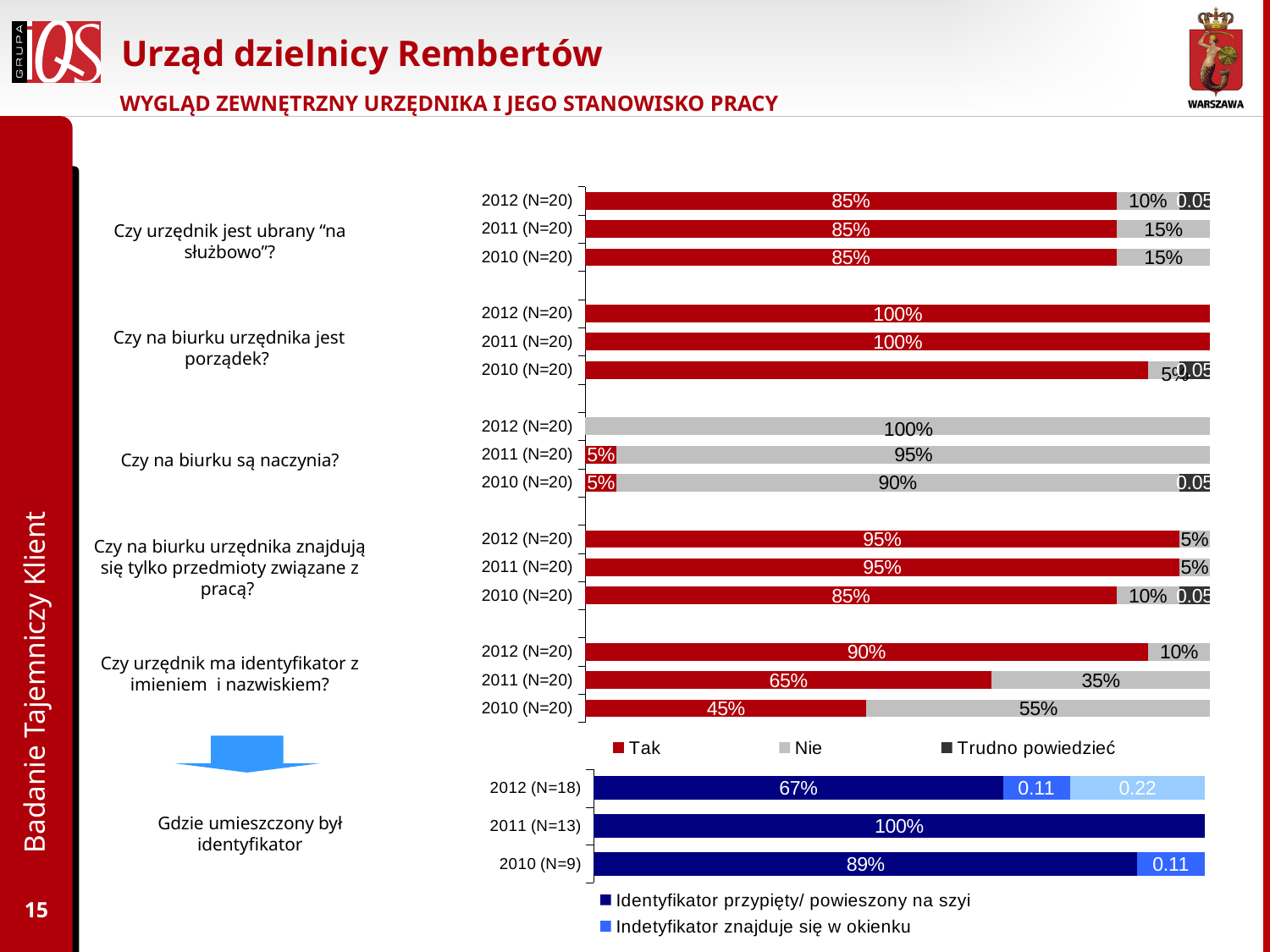
In the upper chart, what percentage answered "Nie" for "Czy urzędnik ma identyfikator z imieniem i nazwiskiem?" in 2011 (N=20)? 35% In the upper chart, what percentage answered "Tak" for "Czy urzędnik ma identyfikator z imieniem i nazwiskiem?" in 2012 (N=20)? 90% In the upper chart, what percentage answered "Nie" for "Czy urzędnik jest ubrany 'na służbowo'?" in 2012 (N=20)? 10% How many series does the legend of the upper chart list? 3 In the upper chart, what percentage answered "Nie" for "Czy na biurku są naczynia?" in 2010 (N=20)? 90% In the upper chart, what is the difference in the "Tak" share for "Czy urzędnik ma identyfikator z imieniem i nazwiskiem?" between 2012 and 2010? 45 percentage points In the lower chart ("Gdzie umieszczony był identyfikator"), what percentage for 2010 (N=9) is "Identyfikator przypięty/ powieszony na szyi"? 89% What kind of chart is the upper chart? stacked bar chart In the lower chart ("Gdzie umieszczony był identyfikator"), what percentage for 2012 (N=18) is "Identyfikator przypięty/ powieszony na szyi"? 67% How many series does the legend of the lower chart list? 2 In the upper chart, does the "Tak" share for "Czy urzędnik ma identyfikator z imieniem i nazwiskiem?" rise or fall from 2010 to 2012? rise In the upper chart, for "Czy urzędnik ma identyfikator z imieniem i nazwiskiem?" in 2011, which is larger: "Tak" or "Nie"? Tak